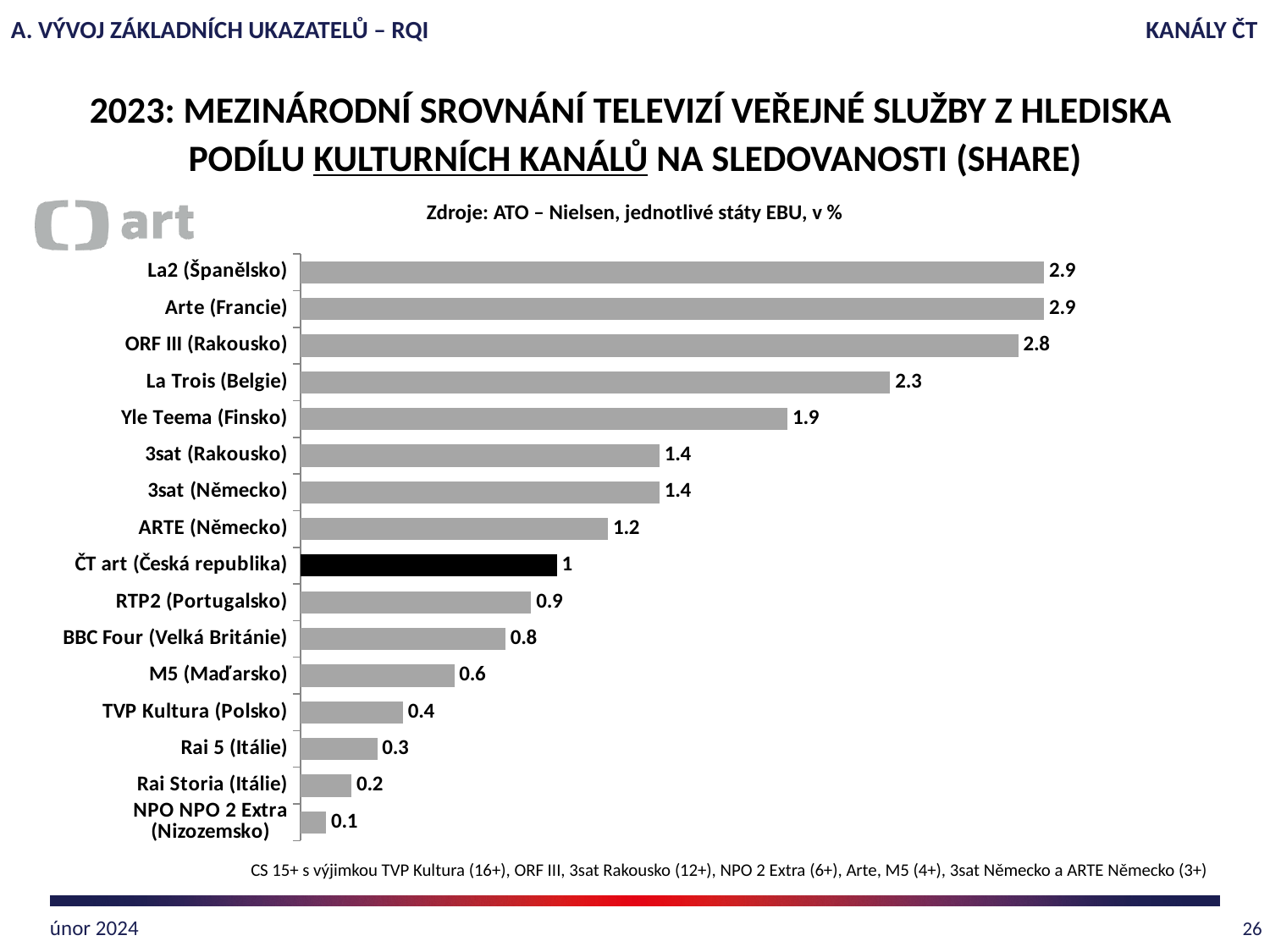
Which bar is drawn in black rather than grey? ČT art (Česká republika) What kind of chart is shown on the slide? bar chart What is the value for Yle Teema (Finsko)? 1.9 What is the difference between the values for ORF III (Rakousko) and La Trois (Belgie)? 0.5 Which is larger, the value for M5 (Maďarsko) or for RTP2 (Portugalsko)? RTP2 (Portugalsko) How many categories are shown in the chart? 16 Which category has the lowest value? NPO NPO 2 Extra (Nizozemsko) What is the value for ORF III (Rakousko)? 2.8 What is the difference between the values for La2 (Španělsko) and ČT art (Česká republika)? 1.9 What is the value for BBC Four (Velká Británie)? 0.8 Which is larger, the value for Yle Teema (Finsko) or for 3sat (Rakousko)? Yle Teema (Finsko) What is the value for ČT art (Česká republika)? 1